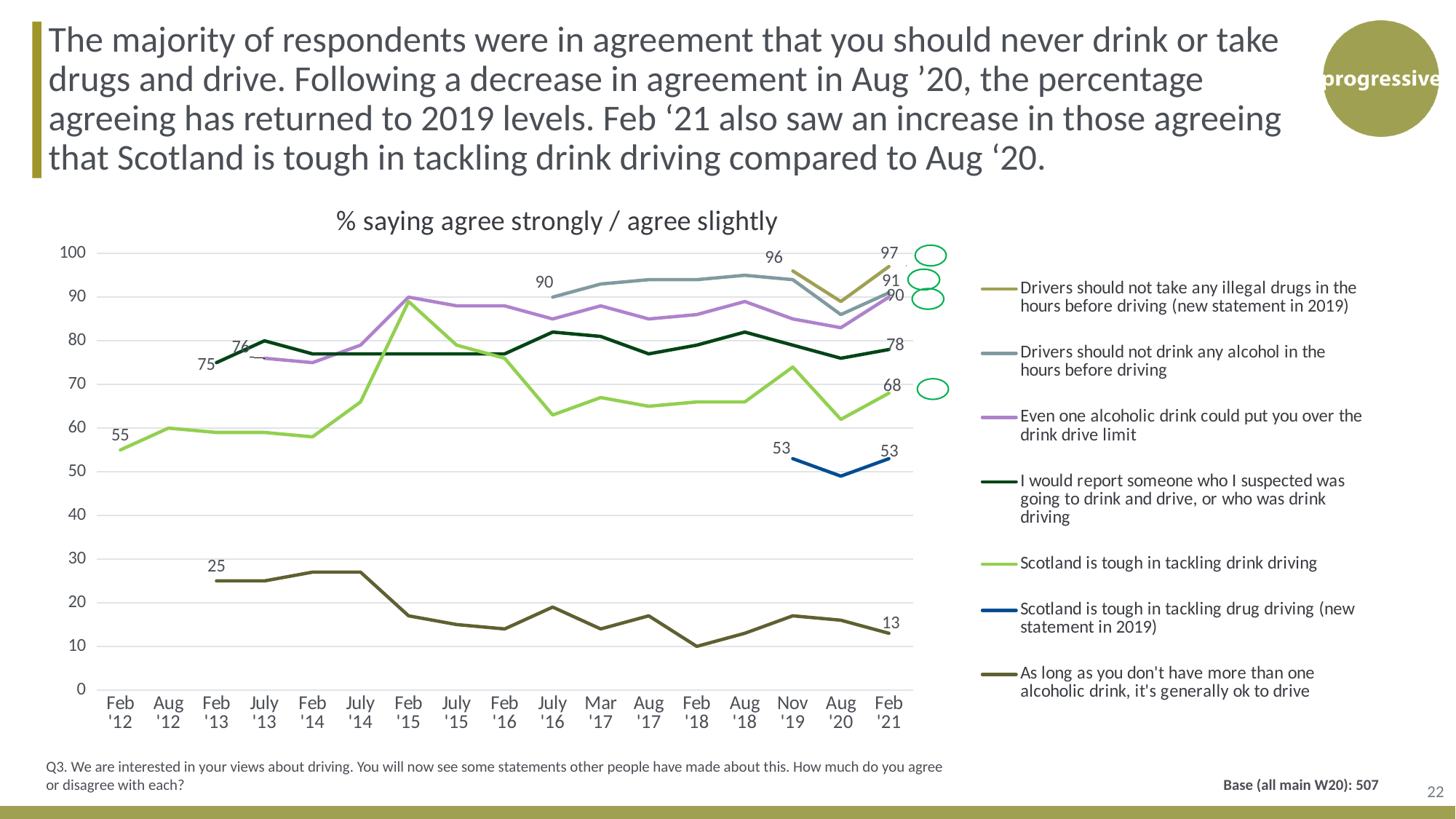
What is the Nov '19 value for 'Scotland is tough in tackling drug driving'? 53 What is the Feb '21 value for 'As long as you don't have more than one alcoholic drink, it's generally ok to drive'? 13 What is the Feb '12 value for 'Scotland is tough in tackling drink driving'? 55 At Feb '21, which is larger: 'I would report someone who I suspected was going to drink and drive' or 'Scotland is tough in tackling drink driving'? I would report someone who I suspected was going to drink and drive How many series does the legend list? 7 Which statement has the lowest value at Feb '21? As long as you don't have more than one alcoholic drink, it's generally ok to drive What is the Feb '21 value for 'Drivers should not take any illegal drugs in the hours before driving'? 97 What kind of chart is shown on the slide? line chart By how much did 'Scotland is tough in tackling drink driving' increase from Feb '12 to Feb '21? 13 Is the Feb '18 value for 'As long as you don't have more than one alcoholic drink, it's generally ok to drive' greater or less than 20? less Which statement has the highest value at Feb '21? Drivers should not take any illegal drugs in the hours before driving How many time points are shown along the x axis? 17